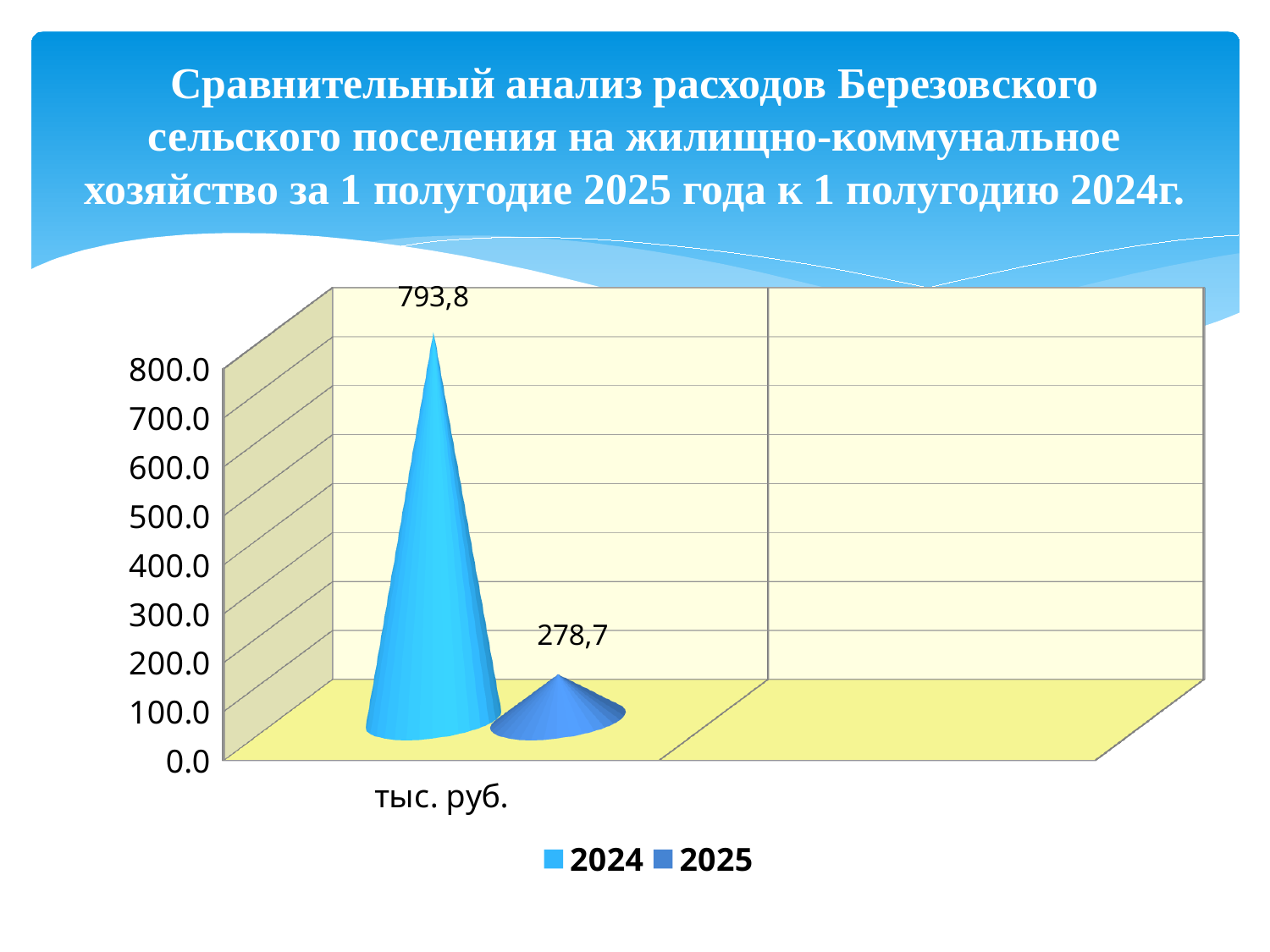
Is the value for 2025 greater or less than 300? less Is the value for 2024 greater or less than 700? greater Which series has the highest value on the chart? 2024 Which series has the lowest value on the chart? 2025 Which series has the higher value, 2024 or 2025? 2024 How many series does the legend list? 2 What is the difference between the 2024 value and the 2025 value? 515,1 What are the two entries in the chart legend? 2024 and 2025 What kind of chart is shown on the slide? Bar chart (3D cone-shaped bars) What is the value for 2024 on the chart? 793,8 What is the value for 2025 on the chart? 278,7 What is the category label shown on the x axis? тыс. руб.